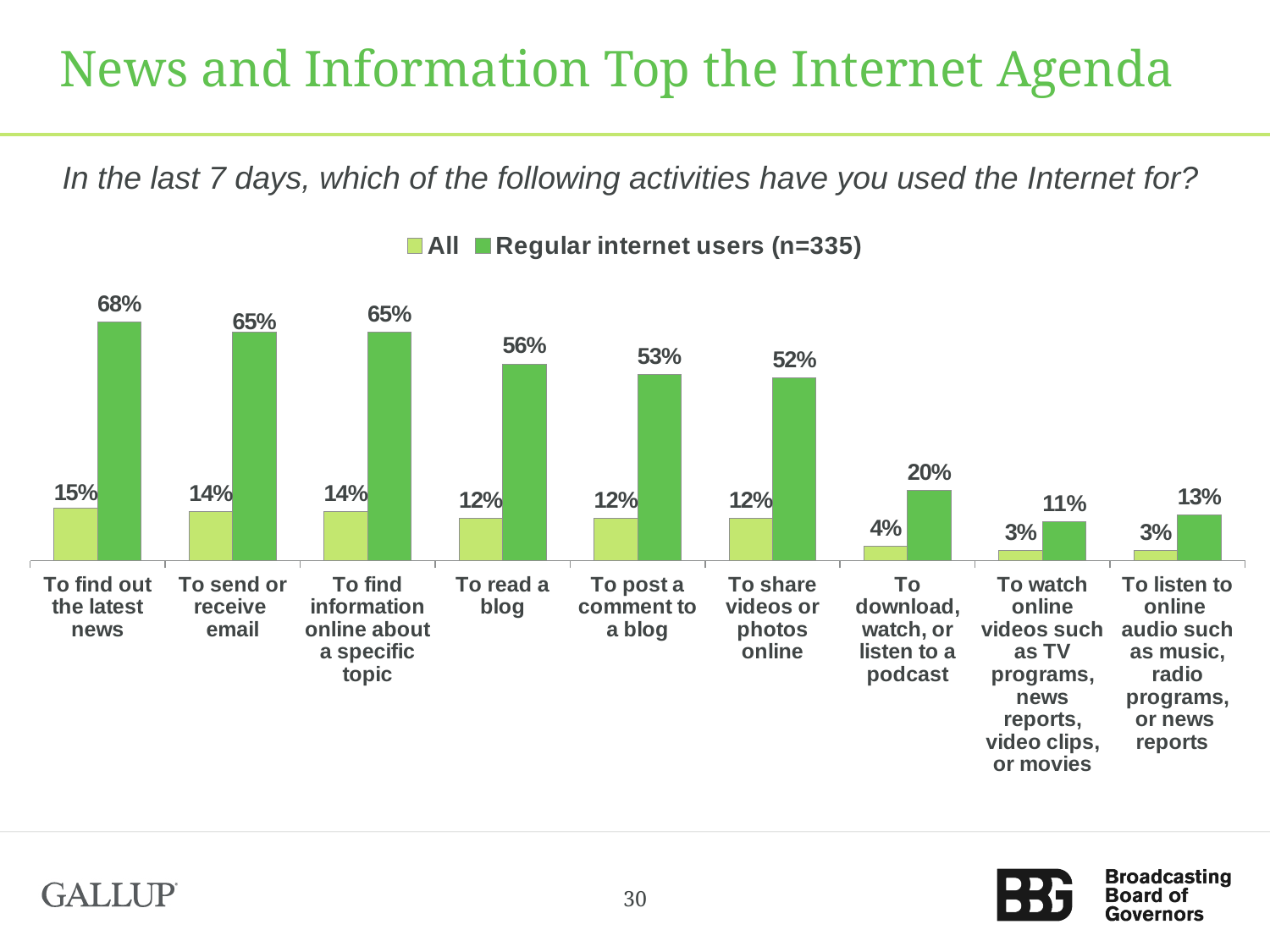
What percentage of regular internet users used the Internet to find out the latest news? 68% What kind of chart is shown on the slide? Bar chart Which activity has the lowest value among regular internet users? To watch online videos such as TV programs, news reports, video clips, or movies How many series does the legend list? 2 What is the value for 'All' for 'To send or receive email'? 14% What is the sample size (n) given for regular internet users in the legend? 335 What is the difference between the 'Regular internet users' and 'All' values for 'To read a blog'? 44 percentage points Which is larger for regular internet users: 'To post a comment to a blog' or 'To share videos or photos online'? To post a comment to a blog What percentage of regular internet users used the Internet to download, watch, or listen to a podcast? 20% How many activities are shown on the x axis? 9 What is the value for 'All' for 'To listen to online audio such as music, radio programs, or news reports'? 3% Which activity has the highest value among regular internet users? To find out the latest news